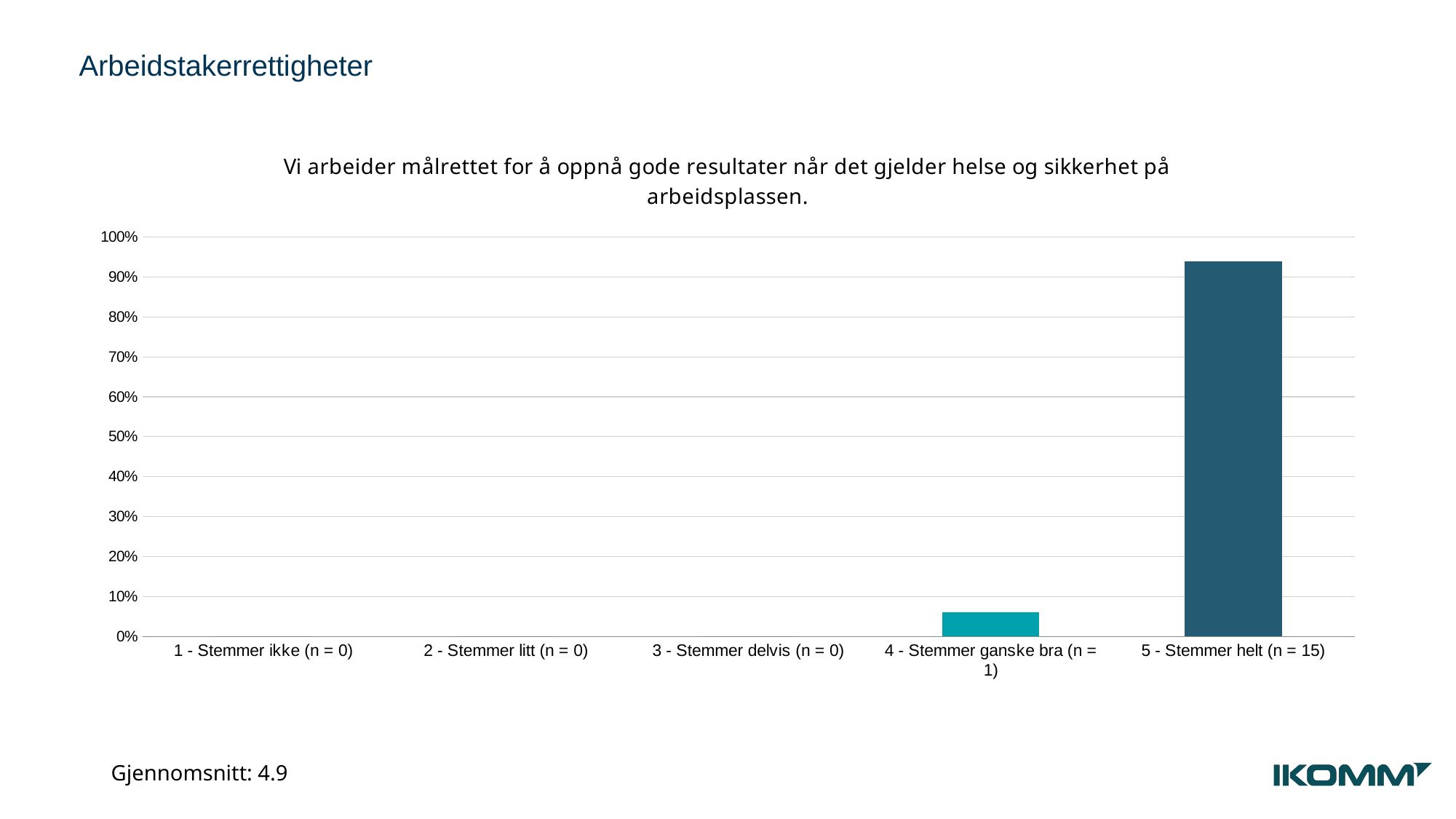
What is the value for 1 - Stemmer ikke? 0% What kind of chart is shown on the slide? bar chart How many respondents (n) are in the category 5 - Stemmer helt? 15 How many categories are shown on the x axis of the chart? 5 Which is larger, the value for 4 - Stemmer ganske bra or the value for 5 - Stemmer helt? 5 - Stemmer helt Is the value for 5 - Stemmer helt greater or less than 90%? greater Is the value for 5 - Stemmer helt greater or less than 100%? less How many categories have n = 0? 3 Which category has the highest value in the chart? 5 - Stemmer helt (n = 15) What average (Gjennomsnitt) is shown below the chart? 4.9 Is the value for 4 - Stemmer ganske bra greater or less than 10%? less What is the title of the chart? Vi arbeider målrettet for å oppnå gode resultater når det gjelder helse og sikkerhet på arbeidsplassen.